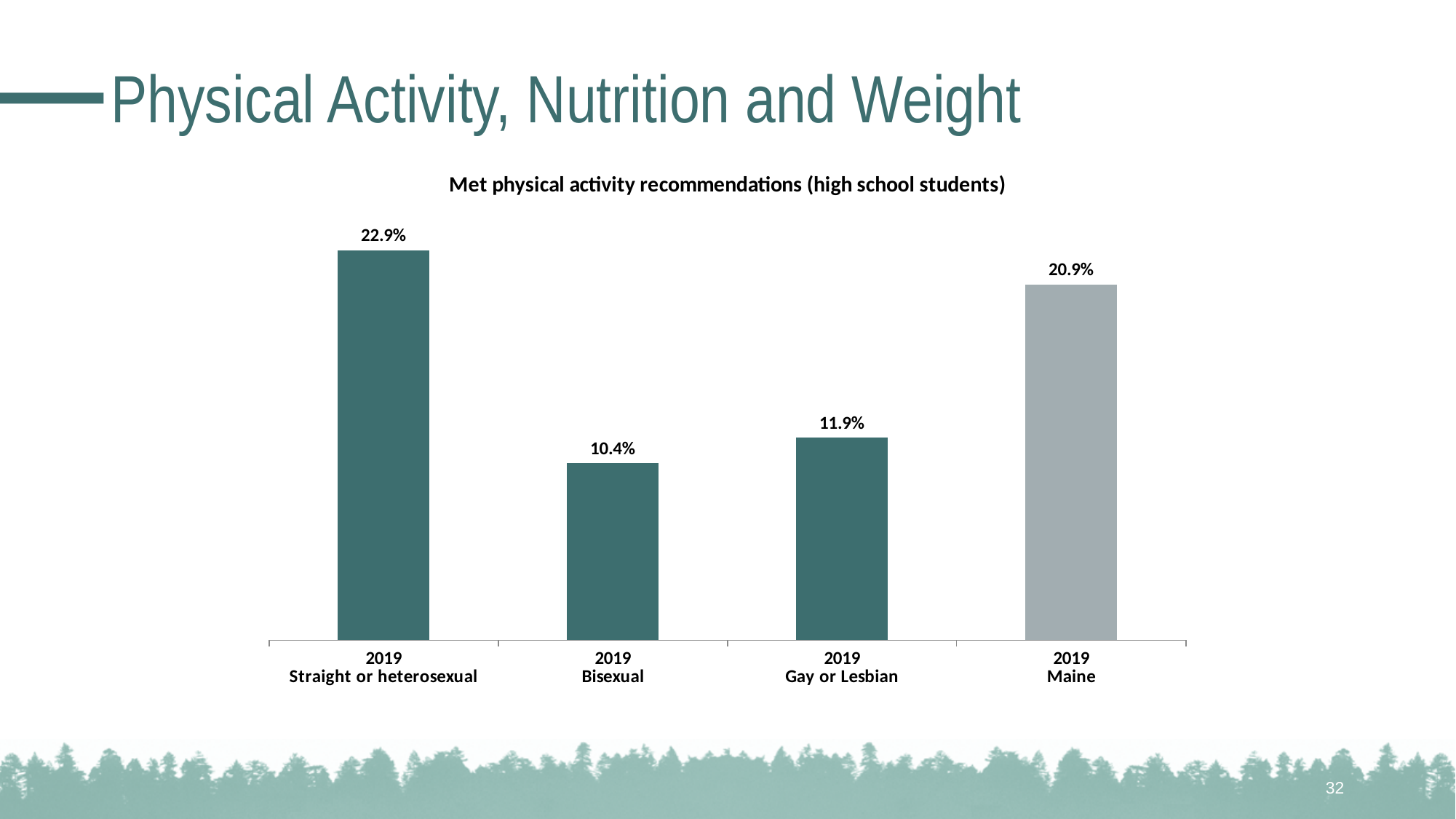
Which category has the lowest percentage of students meeting physical activity recommendations? Bisexual Which category has the highest percentage of students meeting physical activity recommendations? Straight or heterosexual What is the difference between the Maine value and the gay or lesbian value? 9.0% What is the value shown for Maine overall? 20.9% What type of chart is shown on the slide? Bar chart How many bars are shown in the chart? 4 What is the value shown for gay or lesbian students? 11.9% What is the title of the chart? Met physical activity recommendations (high school students) What is the value shown for bisexual students? 10.4% What percentage of straight or heterosexual high school students met physical activity recommendations in 2019? 22.9% Which is larger, the value for straight or heterosexual students or the value for Maine? Straight or heterosexual What is the difference between the straight or heterosexual value and the bisexual value? 12.5%